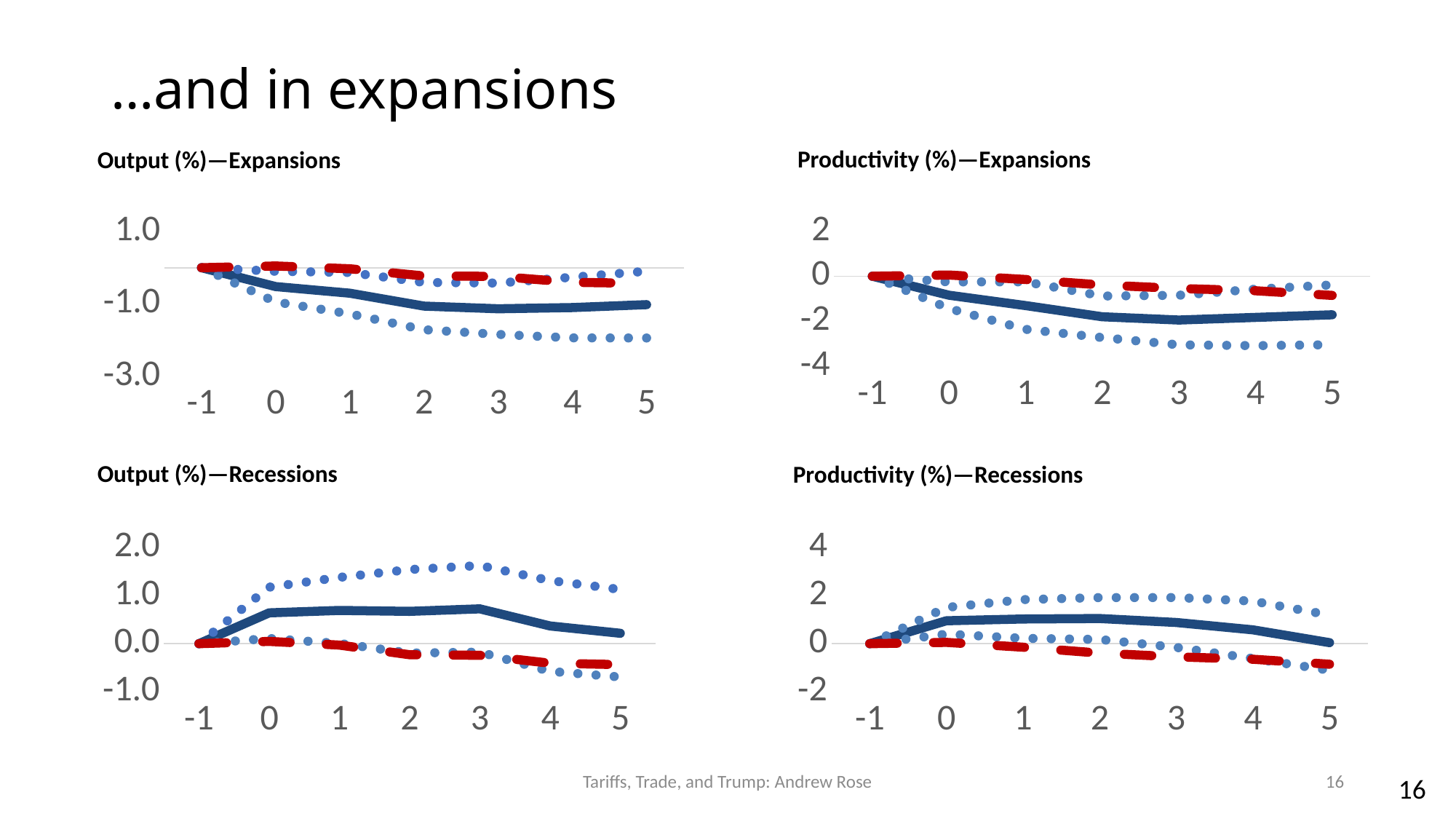
In the "Productivity (%)—Expansions" chart, does the solid line rise or fall from x = -1 to x = 3? fall In the "Output (%)—Expansions" chart, does the solid line rise or fall from x = -1 to x = 5? fall What is the title of the chart in the bottom-right position of the slide? Productivity (%)—Recessions In the "Output (%)—Recessions" chart, does the solid line rise or fall from x = 3 to x = 5? fall In the "Output (%)—Recessions" chart, is the value of the upper dotted line at x = 3 greater or less than 1.0? greater In the "Output (%)—Expansions" chart, is the value of the lower dotted line at x = 5 greater or less than -1.0? less What kind of chart is the "Output (%)—Expansions" chart? line chart In the "Productivity (%)—Expansions" chart, is the value of the lower dotted line at x = 5 greater or less than -2? less How many charts are shown on the slide? 4 In the "Productivity (%)—Recessions" chart, how many points are labelled on the x axis? 7